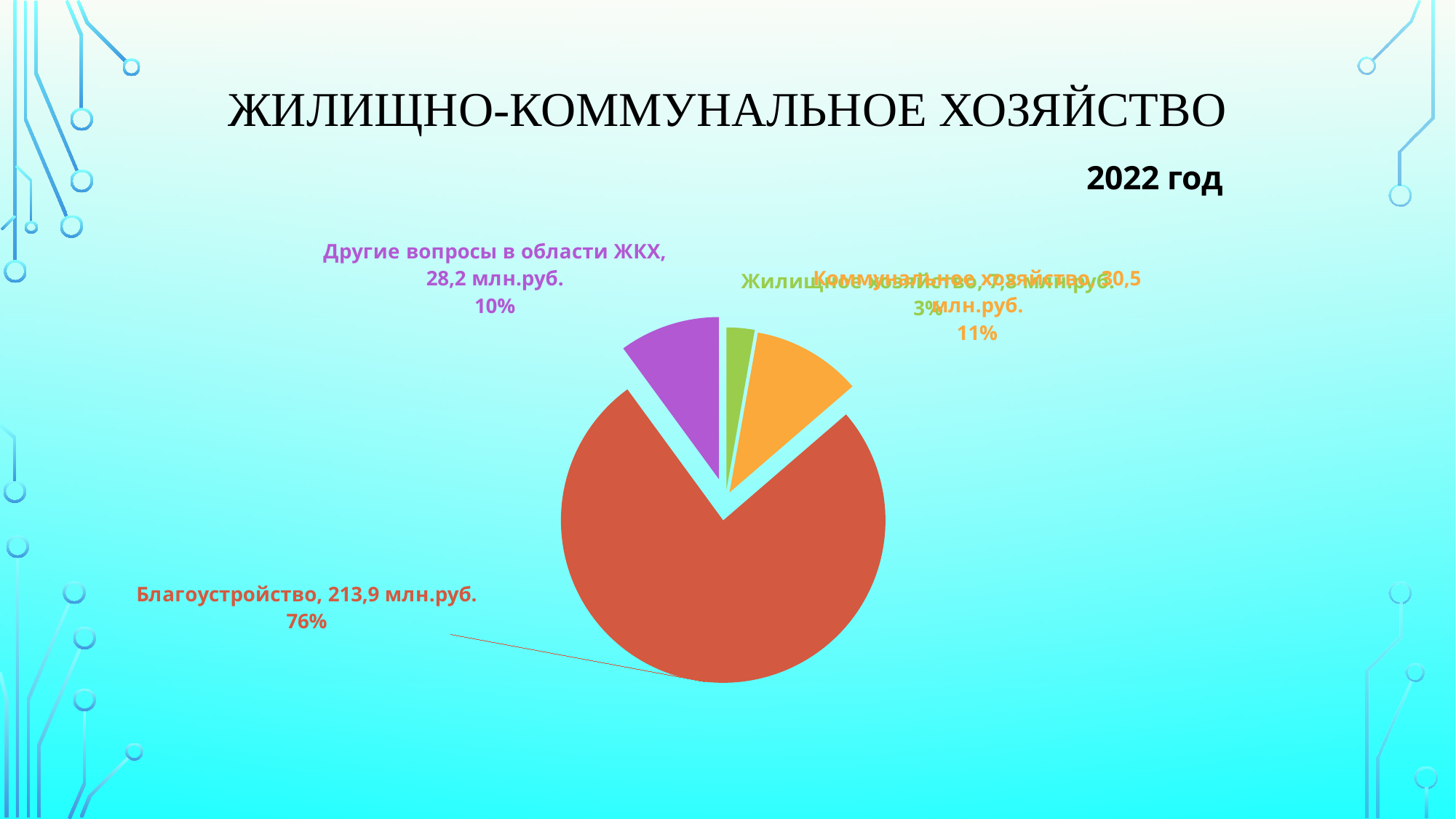
How many slices does the pie chart have? 4 Which category has the largest slice of the pie? Благоустройство Which year does the chart refer to? 2022 год Which category has the smallest slice of the pie? Жилищное хозяйство What is the value for Коммунальное хозяйство? 30,5 млн.руб. Which is larger, Коммунальное хозяйство or Другие вопросы в области ЖКХ? Коммунальное хозяйство What kind of chart is shown on the slide? Pie chart What share of the pie does Благоустройство take? 76% What is the difference between Коммунальное хозяйство and Другие вопросы в области ЖКХ? 2,3 млн.руб. What is the value for Благоустройство? 213,9 млн.руб. What share of the pie does Жилищное хозяйство take? 3% What is the value for Другие вопросы в области ЖКХ? 28,2 млн.руб.